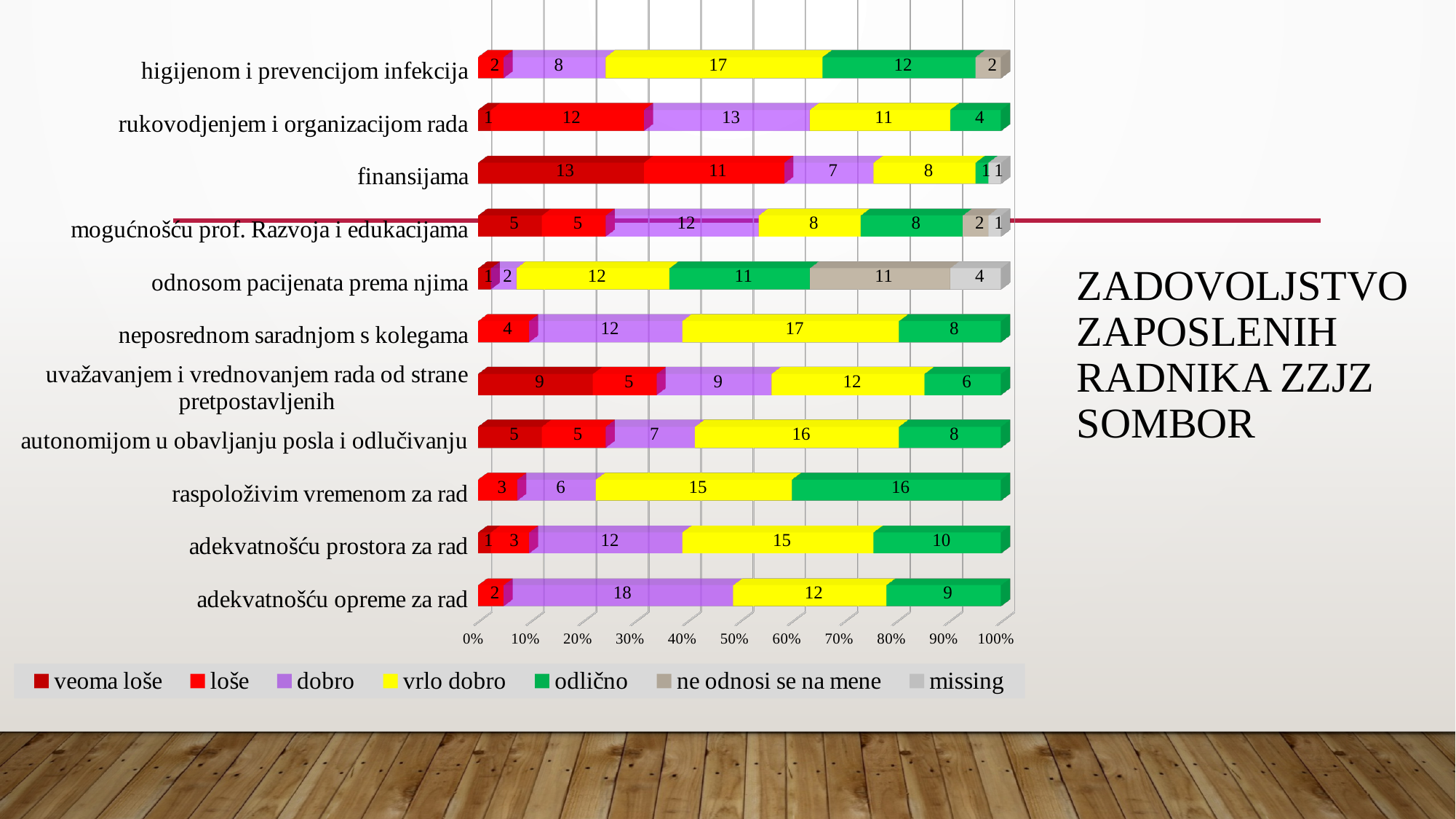
Which category has the highest 'veoma loše' value? finansijama How many categories are plotted on the chart? 11 What is the difference between the 'vrlo dobro' value for 'autonomijom u obavljanju posla i odlučivanju' and the 'vrlo dobro' value for 'finansijama'? 8 What is the 'veoma loše' value for 'finansijama'? 13 What kind of chart is shown on the slide? stacked bar chart Which is larger: the 'loše' value for 'rukovodjenjem i organizacijom rada' or the 'loše' value for 'neposrednom saradnjom s kolegama'? rukovodjenjem i organizacijom rada Which category has the highest 'odlično' value? raspoloživim vremenom za rad What is the 'vrlo dobro' value for 'higijenom i prevencijom infekcija'? 17 What is the total of all values in the bar for 'raspoloživim vremenom za rad'? 40 What is the 'ne odnosi se na mene' value for 'odnosom pacijenata prema njima'? 11 How many series does the legend list? 7 What is the 'dobro' value for 'adekvatnošću opreme za rad'? 18